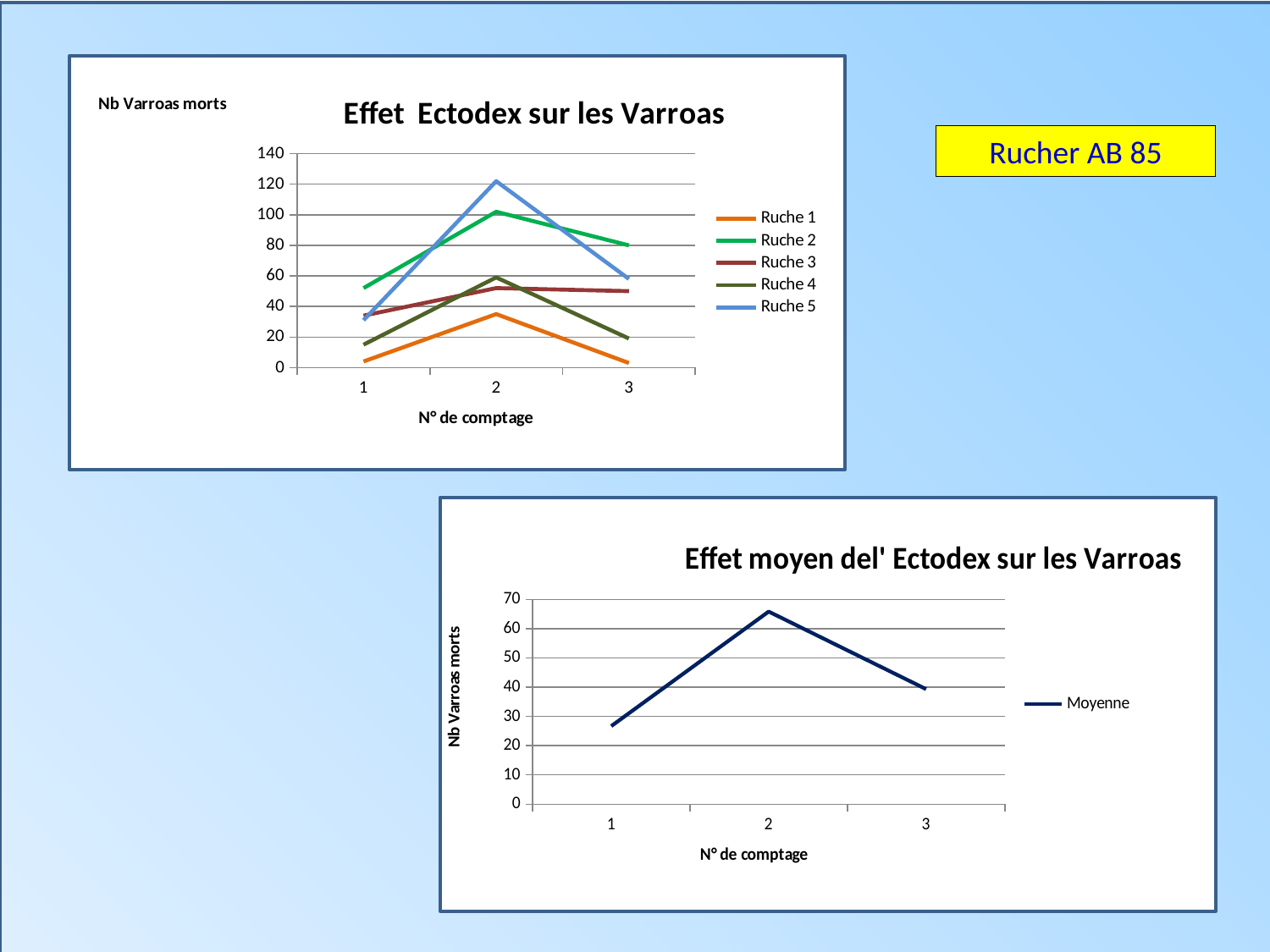
In the top chart "Effet Ectodex sur les Varroas", is the value for Ruche 5 at comptage 2 greater or less than 100? greater In the top chart "Effet Ectodex sur les Varroas", how many series does the legend list? 5 In the bottom chart "Effet moyen del' Ectodex sur les Varroas", how many series does the legend list? 1 In the top chart "Effet Ectodex sur les Varroas", which series has the lowest value at comptage 2? Ruche 1 In the top chart "Effet Ectodex sur les Varroas", is the value for Ruche 1 at comptage 2 greater or less than 40? less In the bottom chart "Effet moyen del' Ectodex sur les Varroas", does the Moyenne line rise or fall from comptage 2 to comptage 3? fall What is the name of the series shown in the legend of the bottom chart? Moyenne In the top chart "Effet Ectodex sur les Varroas", at comptage 1, which is larger: Ruche 2 or Ruche 4? Ruche 2 What kind of chart is the top chart titled "Effet Ectodex sur les Varroas"? line chart In the top chart "Effet Ectodex sur les Varroas", which series has the highest value at comptage 2? Ruche 5 In the bottom chart "Effet moyen del' Ectodex sur les Varroas", is the Moyenne value at comptage 2 greater or less than 60? greater In the top chart "Effet Ectodex sur les Varroas", how many counting points (N° de comptage) are shown on the x axis? 3